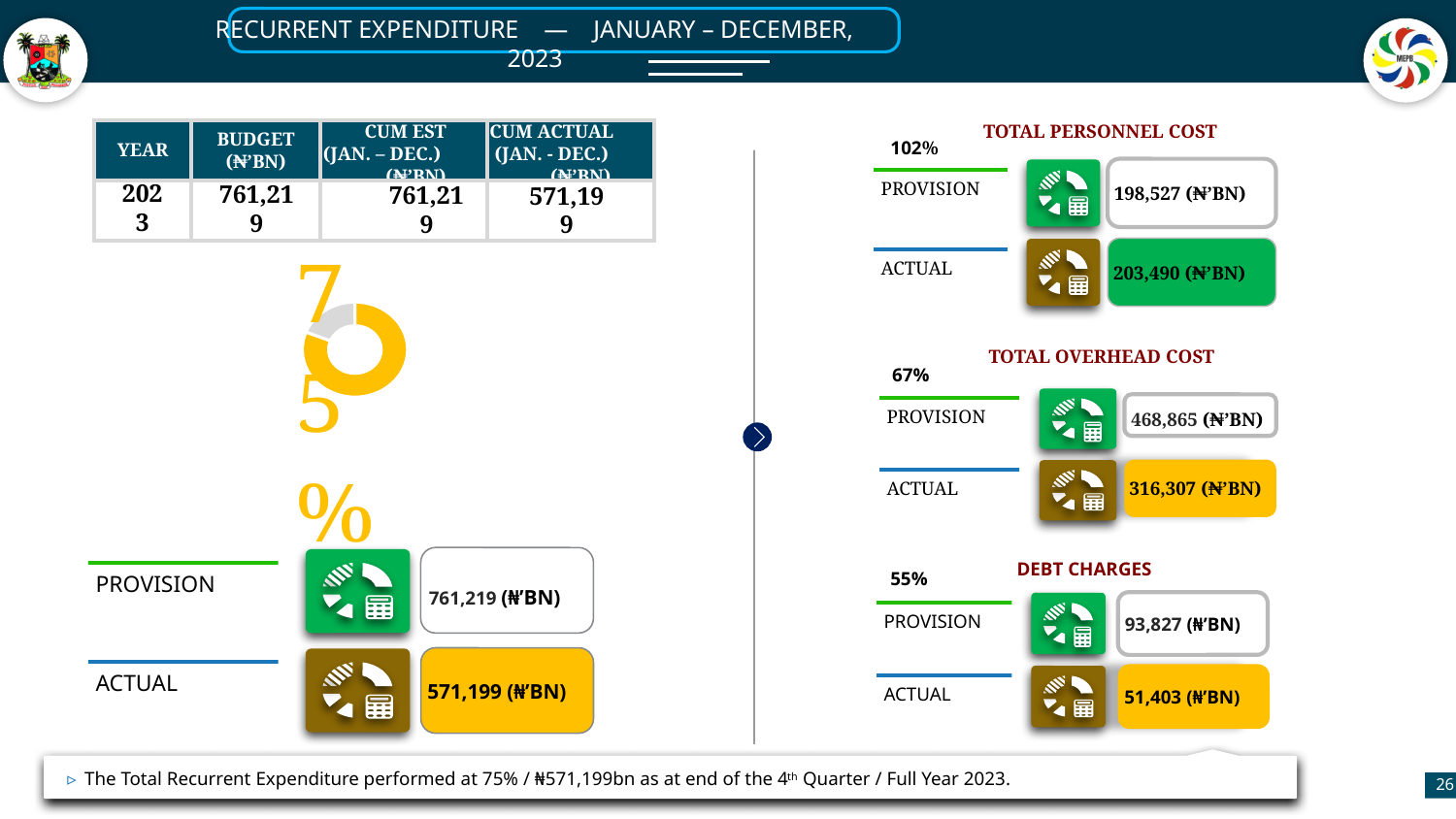
What colour is the filled portion of the doughnut chart? yellow According to the slide, what does the 75% in the doughnut chart represent? Total Recurrent Expenditure performance What is the PROVISION value shown beneath the doughnut chart? 761,219 (₦'BN) What is the difference between the PROVISION value (761,219) and the ACTUAL value (571,199) shown beneath the doughnut chart? 190,020 What is the ACTUAL value shown beneath the doughnut chart? 571,199 (₦'BN) What percentage is printed in the centre of the doughnut chart? 75% Is the share shown by the doughnut chart greater or less than 50%? greater What share of the doughnut chart does the filled (yellow) portion represent? 75% Beneath the doughnut chart, which is larger, the PROVISION value or the ACTUAL value? PROVISION What kind of chart is shown on the left side of the slide? doughnut chart